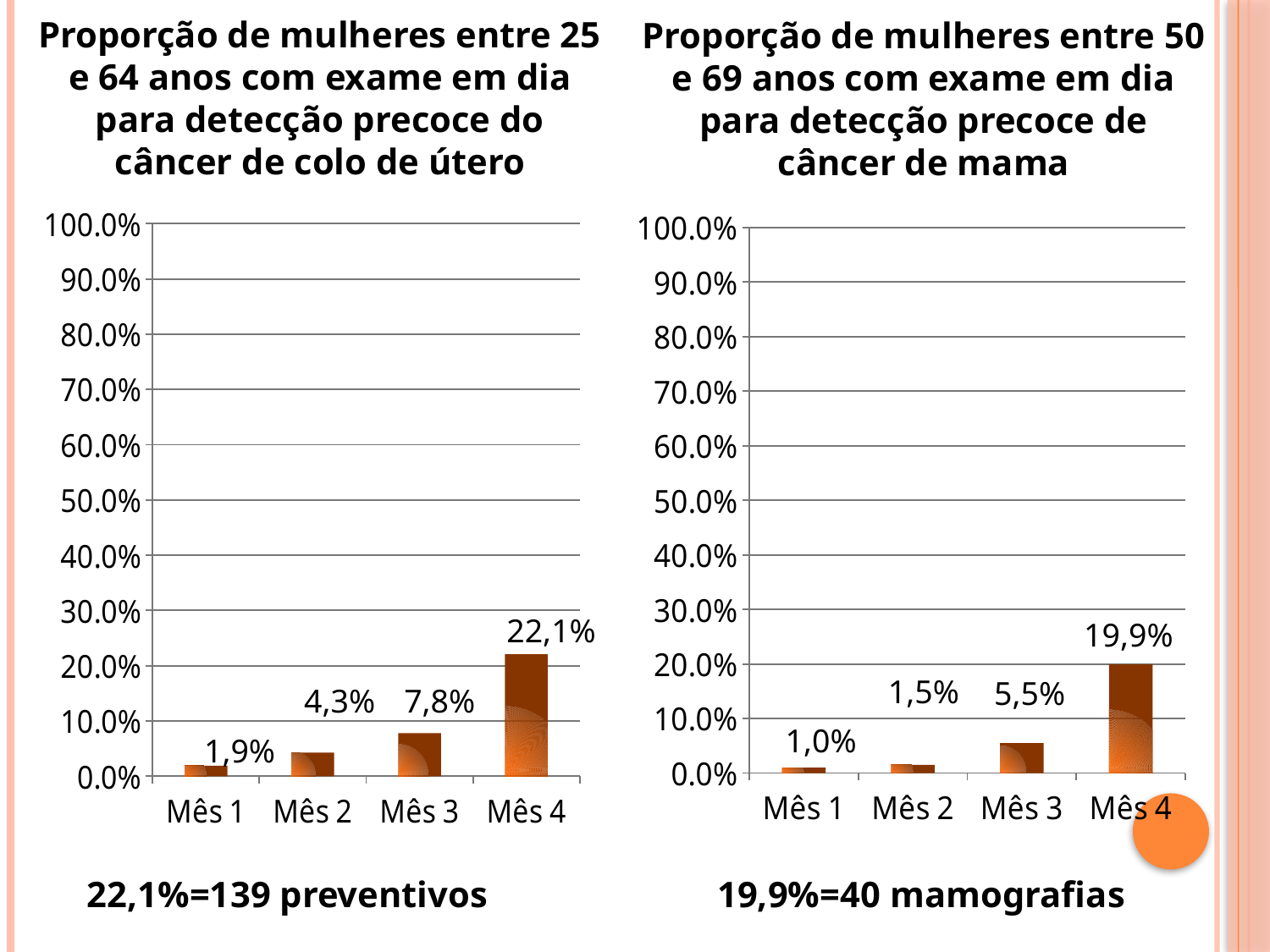
In the left chart (câncer de colo de útero), what is the difference between Mês 4 and Mês 3? 14,3% In the right chart (câncer de mama), which month has the lowest value? Mês 1 Which is larger: Mês 4 in the left chart (colo de útero) or Mês 4 in the right chart (mama)? Mês 4 in the left chart (22,1%) In the left chart (câncer de colo de útero), what is the value for Mês 4? 22,1% In the left chart (câncer de colo de útero), what is the value for Mês 2? 4,3% In the left chart (câncer de colo de útero), which month has the highest value? Mês 4 In the left chart (câncer de colo de útero), do the values rise or fall from Mês 1 to Mês 4? Rise In the right chart (câncer de mama), is the value for Mês 4 greater or less than 30.0%? less What type of chart is the right chart (câncer de mama)? Bar chart In the right chart (câncer de mama), what is the difference between Mês 4 and Mês 1? 18,9% How many months are shown on the x axis of the left chart (câncer de colo de útero)? 4 In the right chart (câncer de mama), what is the value for Mês 3? 5,5%